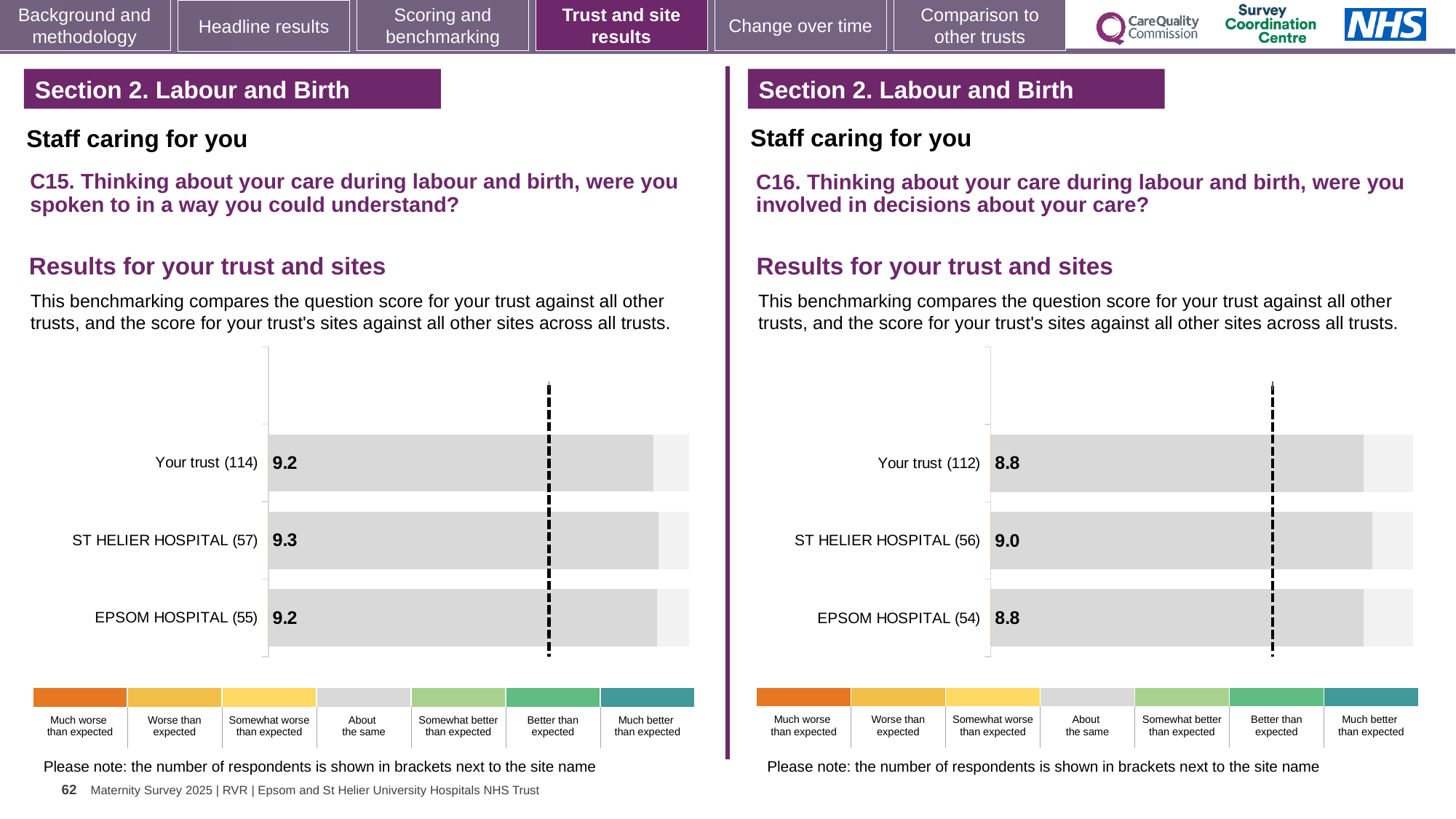
How many bars are shown in the C15 chart on the left? 3 In the C16 chart on the right, what is the difference between the scores for ST HELIER HOSPITAL and Your trust? 0.2 In the C16 chart on the right, is the score for ST HELIER HOSPITAL higher or lower than the score for EPSOM HOSPITAL? higher In the C15 chart on the left, what is the score for ST HELIER HOSPITAL? 9.3 In the C16 chart on the right, which site or trust has the highest score? ST HELIER HOSPITAL In the C16 chart on the right, what is the score for ST HELIER HOSPITAL? 9.0 What type of chart is used in the C16 chart on the right? bar chart In the C16 chart on the right, how many respondents are shown in brackets for Your trust? 112 In the C16 chart on the right, what is the score for EPSOM HOSPITAL? 8.8 In the C15 chart on the left, what is the score for Your trust? 9.2 In the C15 chart on the left, which site or trust has the highest score? ST HELIER HOSPITAL In the C15 chart on the left, what is the difference between the scores for ST HELIER HOSPITAL and EPSOM HOSPITAL? 0.1